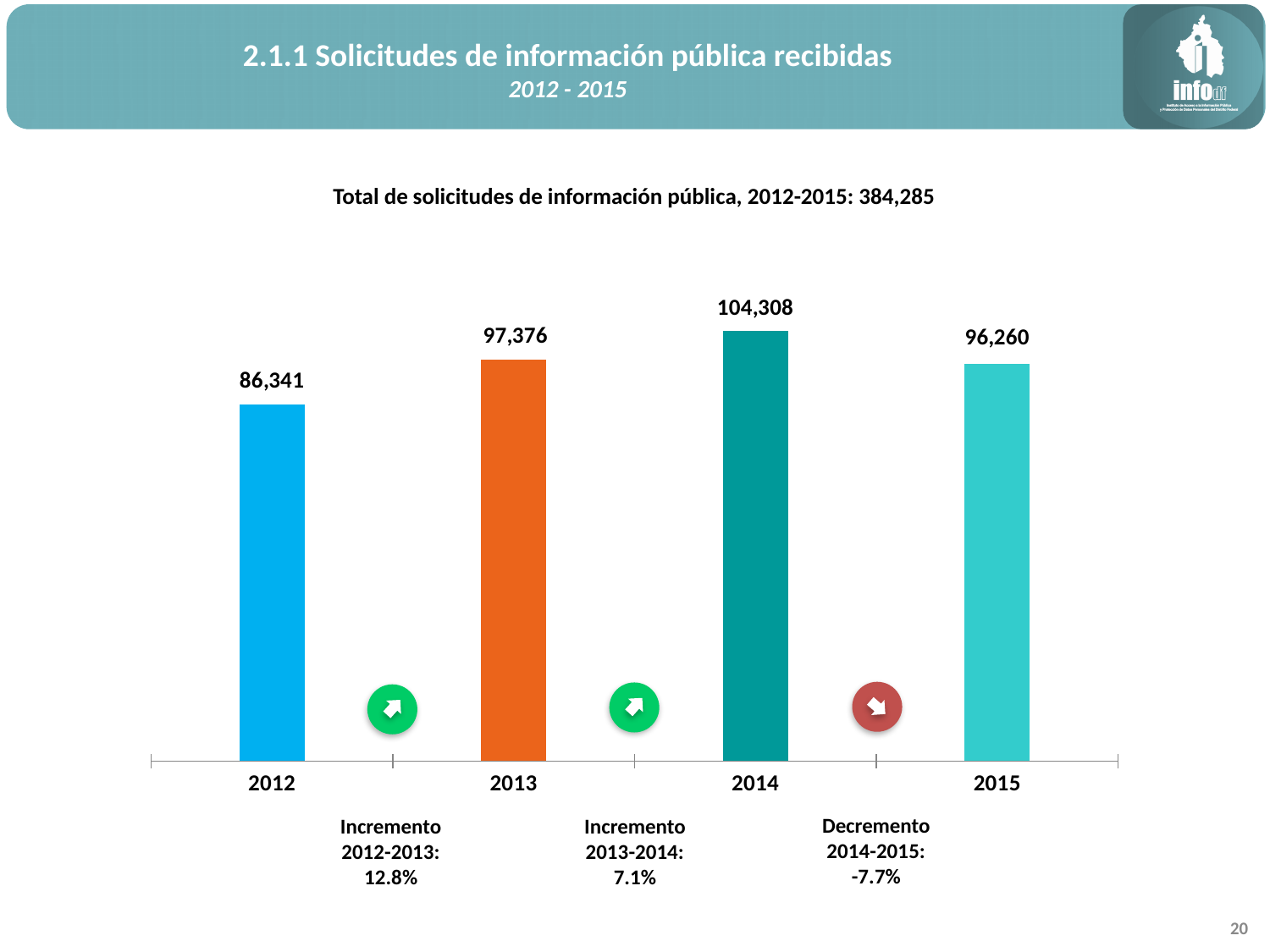
What is the value for 2014? 104,308 What kind of chart is shown on the slide? bar chart What is the value for 2012? 86,341 Which year has the highest value? 2014 What is the difference between the values for 2014 and 2013? 6,932 How many years are shown on the x axis? 4 What total of solicitudes for 2012-2015 is stated above the chart? 384,285 Do the values rise or fall from 2012 to 2014? rise What is the difference between the values for 2015 and 2012? 9,919 What is the value for 2015? 96,260 Which year has the lowest value? 2012 Which is larger, the value for 2013 or the value for 2015? 2013